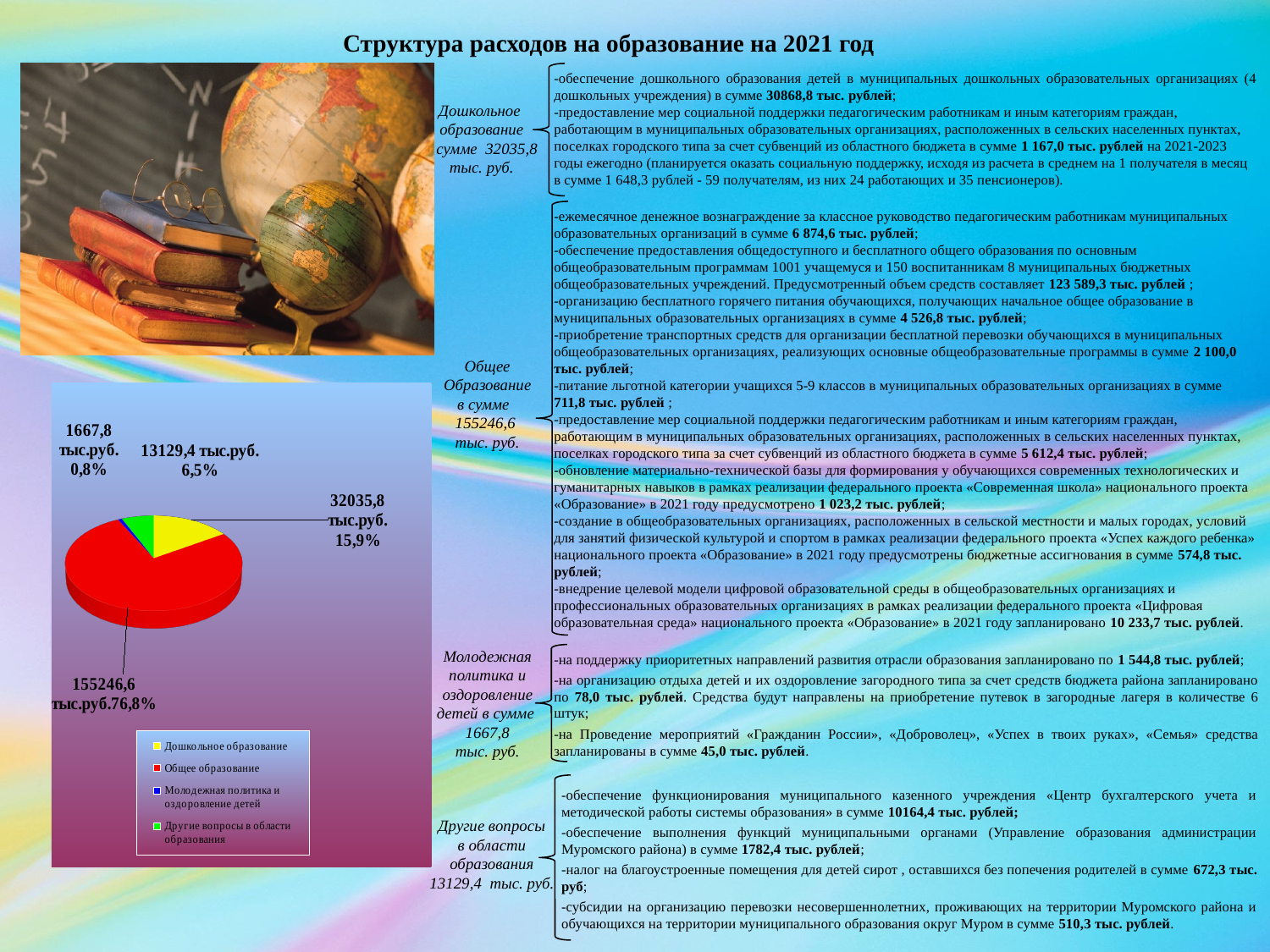
What kind of chart is shown on the slide? Pie chart What percentage share does Дошкольное образование have in the pie chart? 15,9% How many entries does the legend of the pie chart list? 4 Which category has the largest slice in the pie chart? Общее образование Which category has the smallest slice in the pie chart? Молодежная политика и оздоровление детей How many slices does the pie chart have? 4 What value is shown for Другие вопросы в области образования in the pie chart? 13129,4 тыс.руб. What colour is the slice for Общее образование in the pie chart? Red Which is larger in the pie chart: Дошкольное образование or Другие вопросы в области образования? Дошкольное образование What value is shown for Общее образование in the pie chart? 155246,6 тыс.руб. What percentage share does Молодежная политика и оздоровление детей have in the pie chart? 0,8% What is the difference between the values for Общее образование and Дошкольное образование in the pie chart? 123210,8 тыс.руб.